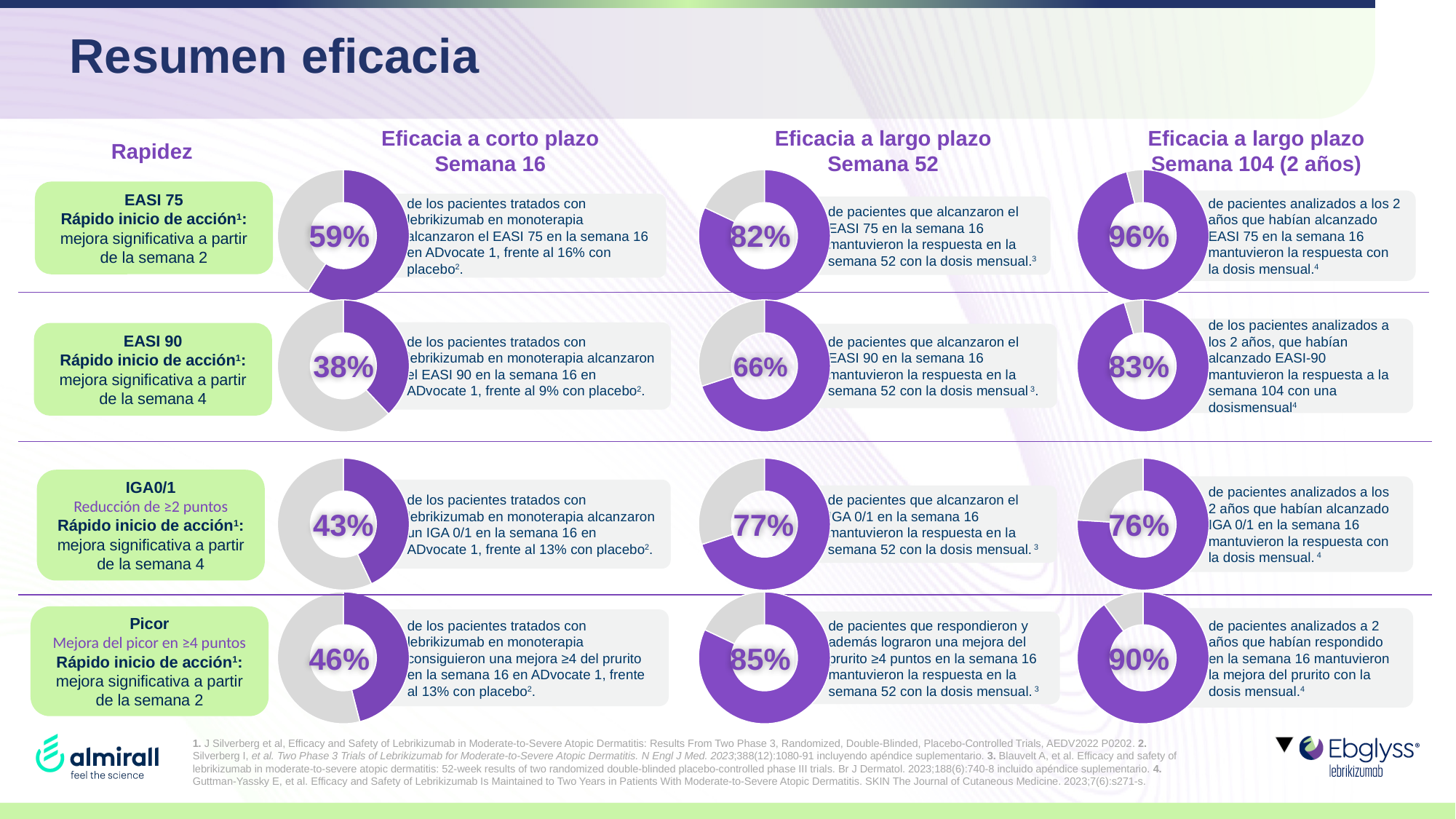
What percentage is shown in the EASI 75 donut chart under 'Eficacia a corto plazo Semana 16'? 59% What kind of chart is used to display each percentage on the slide? Donut chart What percentage is shown in the EASI 90 donut chart under 'Eficacia a largo plazo Semana 52'? 66% What is the difference between the EASI 75 percentage at Semana 52 and the EASI 75 percentage at Semana 16? 23% Among the donut charts in the 'Semana 104 (2 años)' column, which row shows the highest percentage? EASI 75 What percentage is shown in the IGA0/1 donut chart under 'Eficacia a largo plazo Semana 104 (2 años)'? 76% Among the donut charts in the 'Semana 16' column, which row shows the lowest percentage? EASI 90 How many donut charts are shown on the slide? 12 Which is larger: the Picor percentage at Semana 52 or the IGA0/1 percentage at Semana 52? Picor (85%) What percentage is shown in the Picor donut chart under 'Eficacia a corto plazo Semana 16'? 46% For the EASI 90 row, do the percentages rise or fall from Semana 16 to Semana 104? Rise What colour is used for the filled portion of the donut charts? Purple